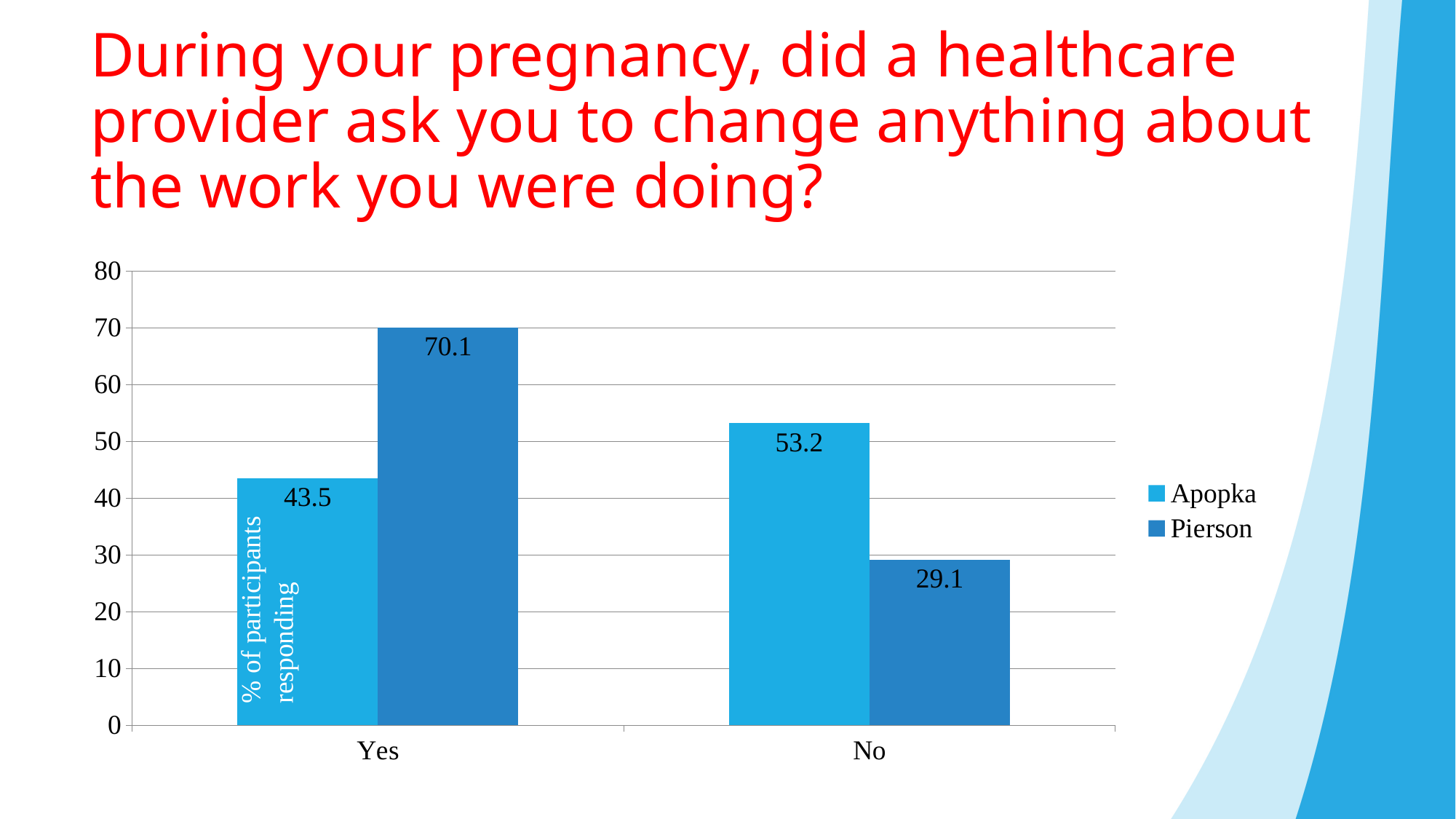
Which bar has the lowest value on the chart? Pierson, No For the No response, which site has the larger value, Apopka or Pierson? Apopka What is the difference between the Pierson and Apopka values for Yes? 26.6 What percentage of Pierson participants answered Yes? 70.1 What percentage of Pierson participants answered No? 29.1 What is the difference between the Apopka and Pierson values for No? 24.1 What percentage of Apopka participants answered No? 53.2 What kind of chart is shown on the slide? Bar chart How many series does the legend list? 2 What is the label on the vertical axis of the chart? % of participants responding Which bar has the highest value on the chart? Pierson, Yes What percentage of Apopka participants answered Yes? 43.5